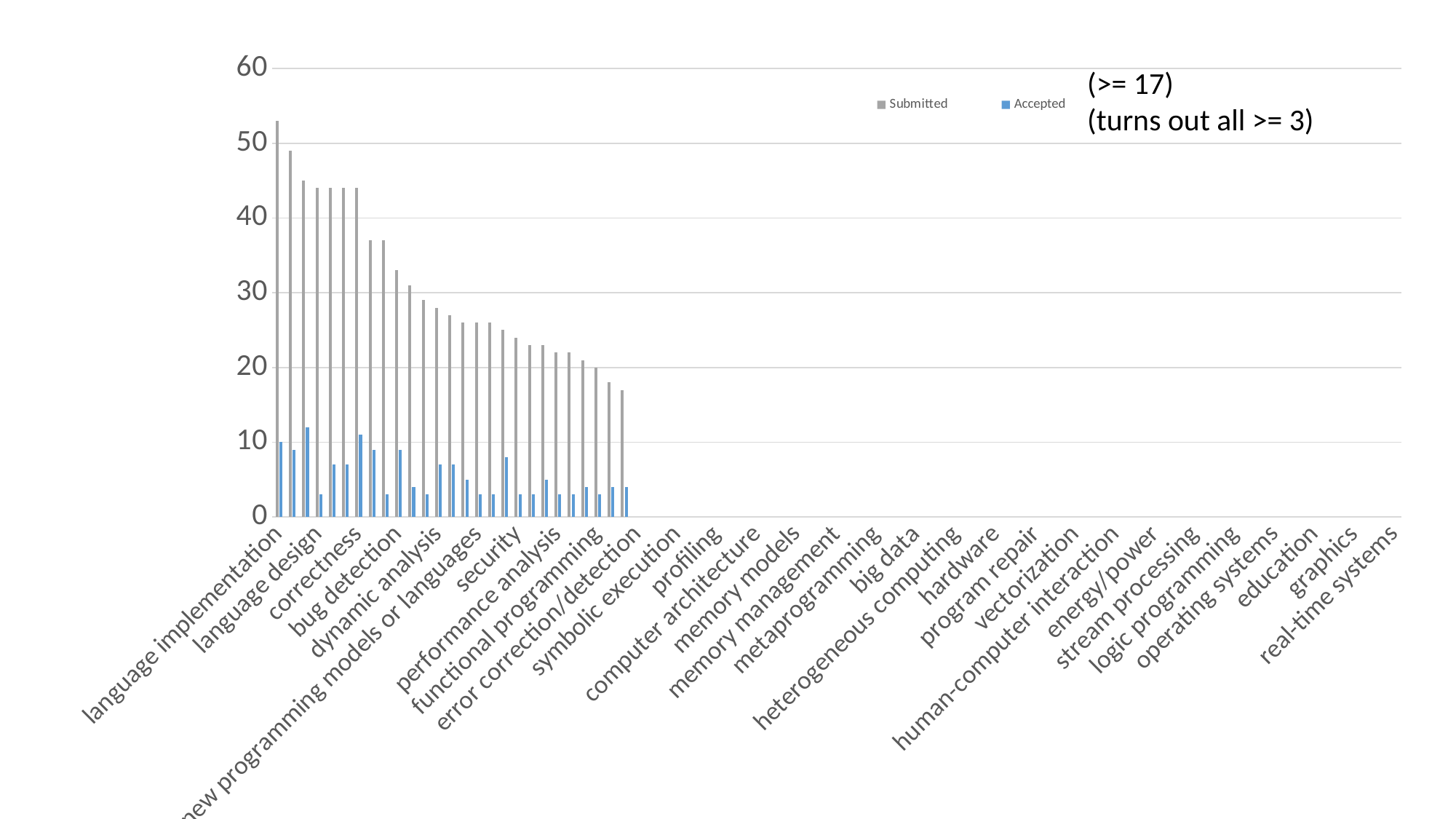
Which colour represents the Accepted series? blue What are the two series named in the legend? Submitted and Accepted How many series does the legend list? 2 Is the Submitted value for language implementation greater or less than 50? greater Is the Accepted value for language implementation greater or less than 20? less Is the Submitted value for language implementation greater or less than 60? less Which category has the highest Submitted value? language implementation What kind of chart is shown on the slide? bar chart Do the Submitted values rise or fall moving from left to right along the x axis? fall For language implementation, which is larger, the Submitted value or the Accepted value? Submitted